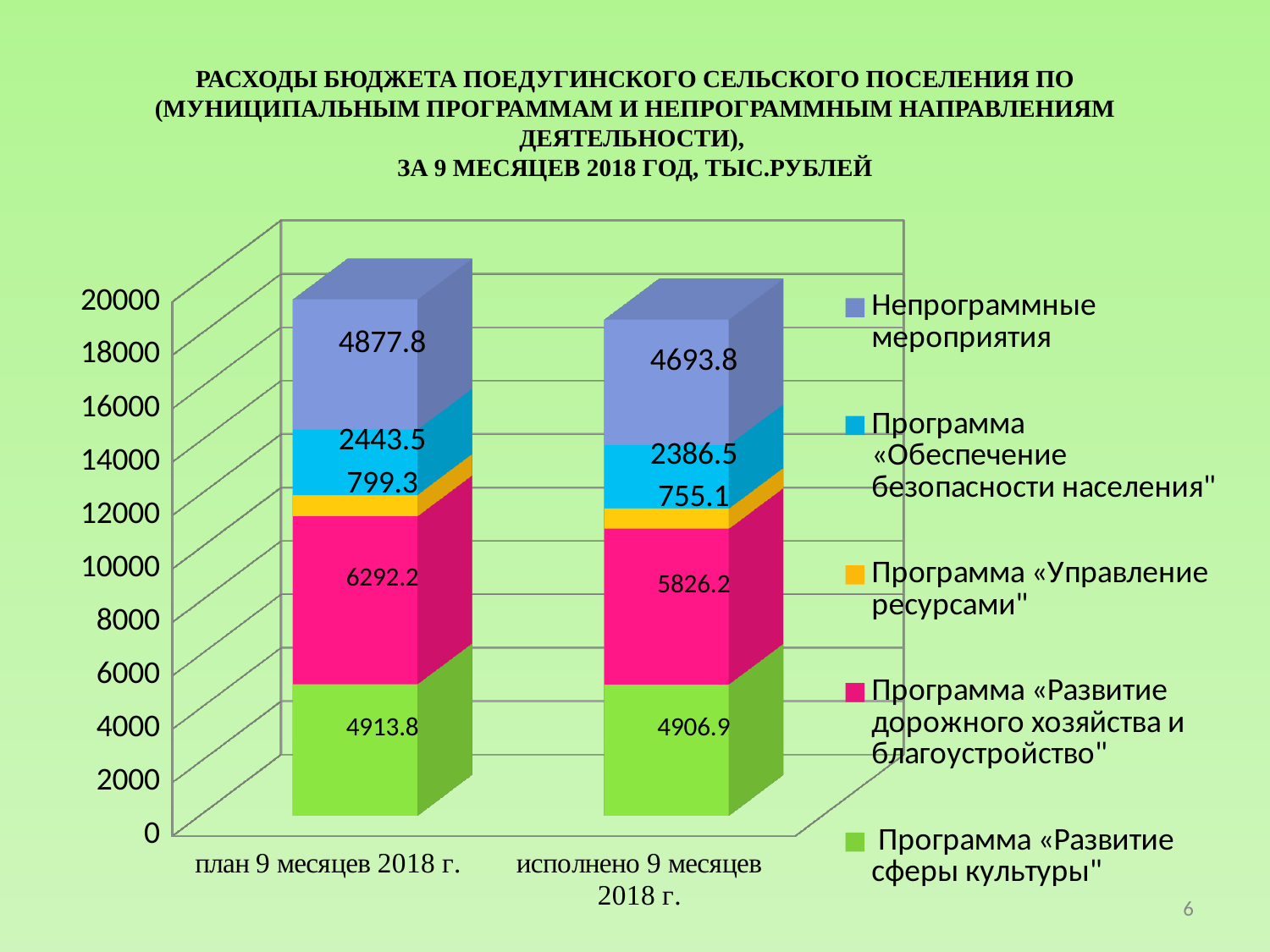
Which series has the smallest segment in the «исполнено 9 месяцев 2018 г.» bar? Программа «Управление ресурсами" What is the difference between the plan and executed values for «Программа «Развитие дорожного хозяйства и благоустройство"»? 466.0 How many series does the legend list? 5 What is the value for «Программа «Развитие дорожного хозяйства и благоустройство"» in the «план 9 месяцев 2018 г.» bar? 6292.2 What is the value for «Программа «Управление ресурсами"» in the «план 9 месяцев 2018 г.» bar? 799.3 Which series has the largest segment in the «план 9 месяцев 2018 г.» bar? Программа «Развитие дорожного хозяйства и благоустройство" Which is larger: the «Программа «Развитие сферы культуры"» value for «план 9 месяцев 2018 г.» or for «исполнено 9 месяцев 2018 г.»? план 9 месяцев 2018 г. What is the value for «Программа «Обеспечение безопасности населения"» in the «исполнено 9 месяцев 2018 г.» bar? 2386.5 What kind of chart is shown on the slide? Stacked bar chart What is the total of the «план 9 месяцев 2018 г.» stacked bar? 19326.6 What is the value for «Непрограммные мероприятия» in the «исполнено 9 месяцев 2018 г.» bar? 4693.8 What is the difference between the plan and executed values for «Непрограммные мероприятия»? 184.0